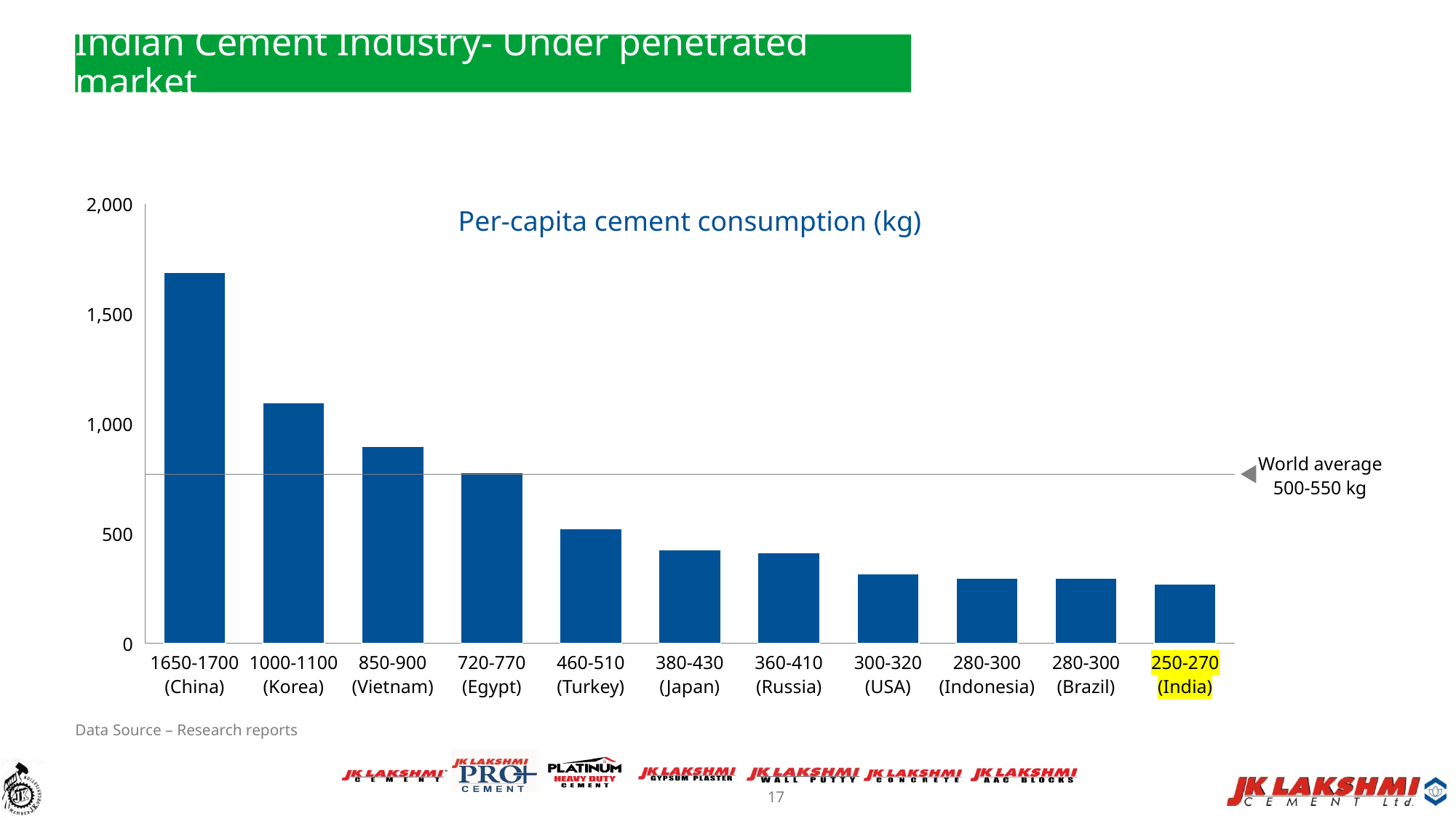
Which has the higher per-capita cement consumption, Korea or Vietnam? Korea What world average range is annotated on the chart? 500-550 kg What per-capita cement consumption range is shown for India? 250-270 What per-capita cement consumption range is shown for Egypt? 720-770 What is the title of the chart? Per-capita cement consumption (kg) What per-capita cement consumption range is shown for China? 1650-1700 Which country has the highest per-capita cement consumption in the chart? China Is the value for Turkey greater or less than 1,000? less How many countries are shown in the chart? 11 Which country has the lowest per-capita cement consumption in the chart? India Do the bars rise or fall from left to right across the chart? Fall What kind of chart is shown on the slide? Bar chart